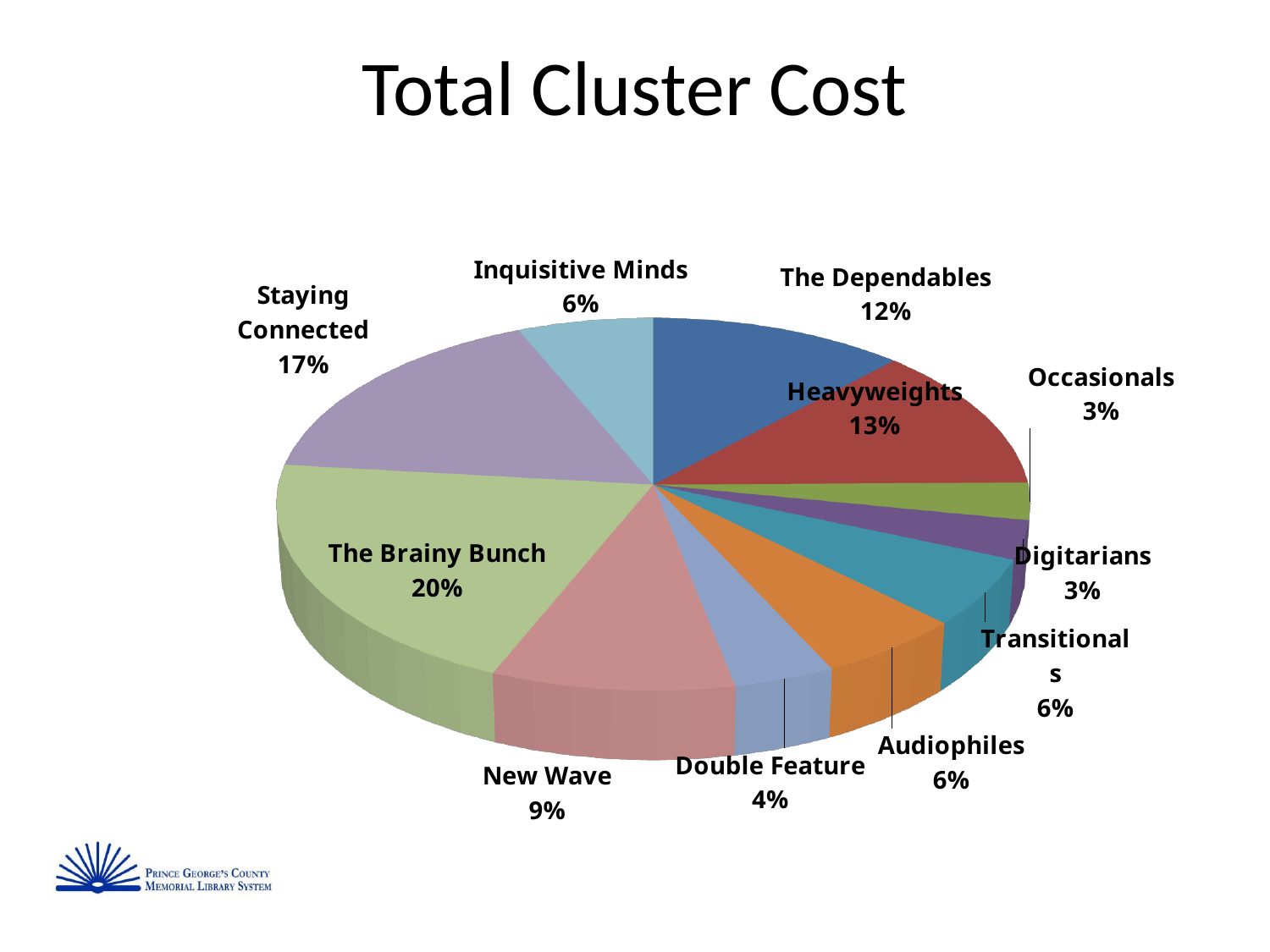
What percentage is shown for Double Feature? 4% What percentage is shown for Heavyweights? 13% What kind of chart is shown on the slide? pie chart How many slices does the pie chart have? 11 What is the title of the chart? Total Cluster Cost What share of the pie does The Brainy Bunch represent? 20% What is the difference in percentage points between Staying Connected and Occasionals? 14 Which has a larger share, Staying Connected or Inquisitive Minds? Staying Connected Which has a larger share, The Dependables or Heavyweights? Heavyweights Which cluster has the largest share of the pie? The Brainy Bunch What is the difference in percentage points between The Brainy Bunch and New Wave? 11 What percentage is shown for Staying Connected? 17%